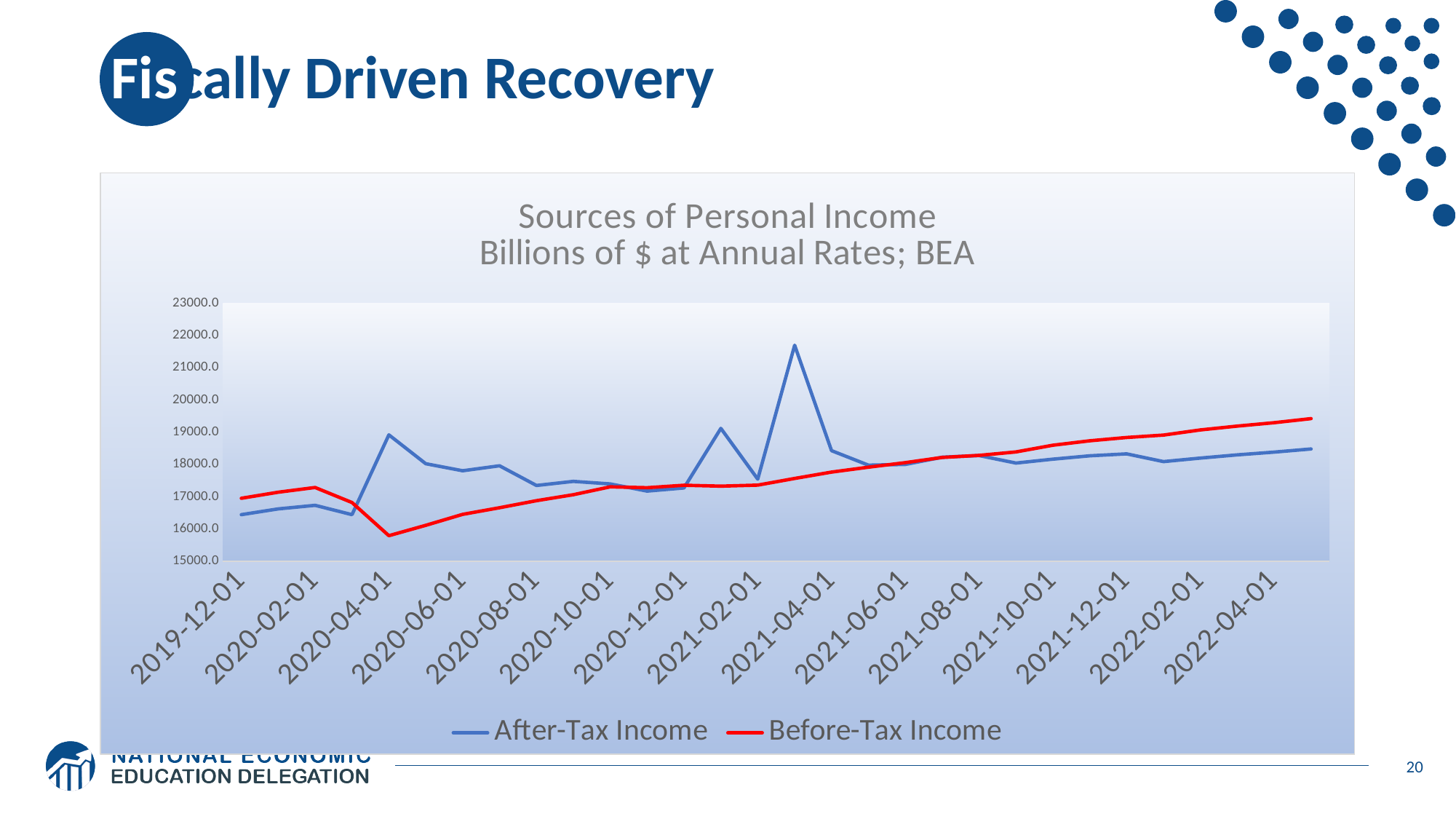
What kind of chart is shown on the slide? line chart Which series reaches the lowest value anywhere on the chart? Before-Tax Income How many dates are labelled on the x axis? 15 Is the value of Before-Tax Income at 2020-04-01 greater or less than 16000? less How many series does the legend list? 2 Is the value of Before-Tax Income at 2022-04-01 greater or less than 19000? greater Which series reaches the highest value anywhere on the chart? After-Tax Income At 2022-04-01, which is higher: After-Tax Income or Before-Tax Income? Before-Tax Income What is the title of the chart? Sources of Personal Income Billions of $ at Annual Rates; BEA Which colour is used for the Before-Tax Income line? red From 2020-06-01 to 2022-04-01, does Before-Tax Income rise or fall? rise Is the value of After-Tax Income at 2019-12-01 greater or less than 17000? less